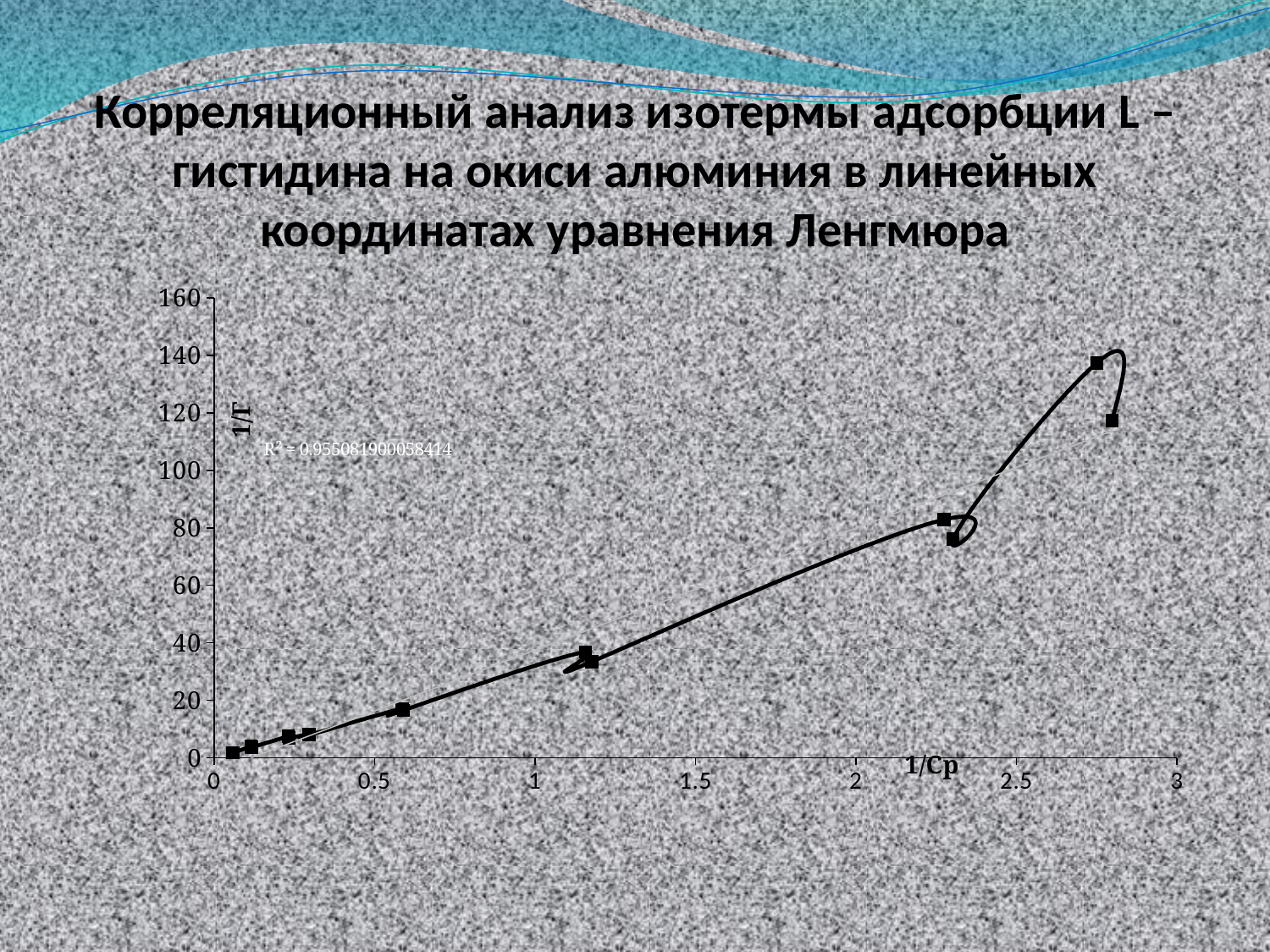
What is the label of the x axis of the chart? 1/Cp Is the 1/Г value of the point near 1/Cp = 2.27 greater or less than 60? greater Is the 1/Г value of the point near 1/Cp = 2.75 greater or less than 120? greater What is the highest tick value shown on the y axis? 160 Is the 1/Г value of the point near 1/Cp = 1.15 greater or less than 60? less What is the label of the y axis of the chart? 1/Г Do the plotted 1/Г values generally rise or fall as 1/Cp increases along the x axis? rise What R² value is printed on the chart? R² = 0.955081900058414 Which has the larger 1/Г value: the point near 1/Cp = 2.27 or the point near 1/Cp = 0.6? the point near 1/Cp = 2.27 What kind of chart is shown on the slide? line chart